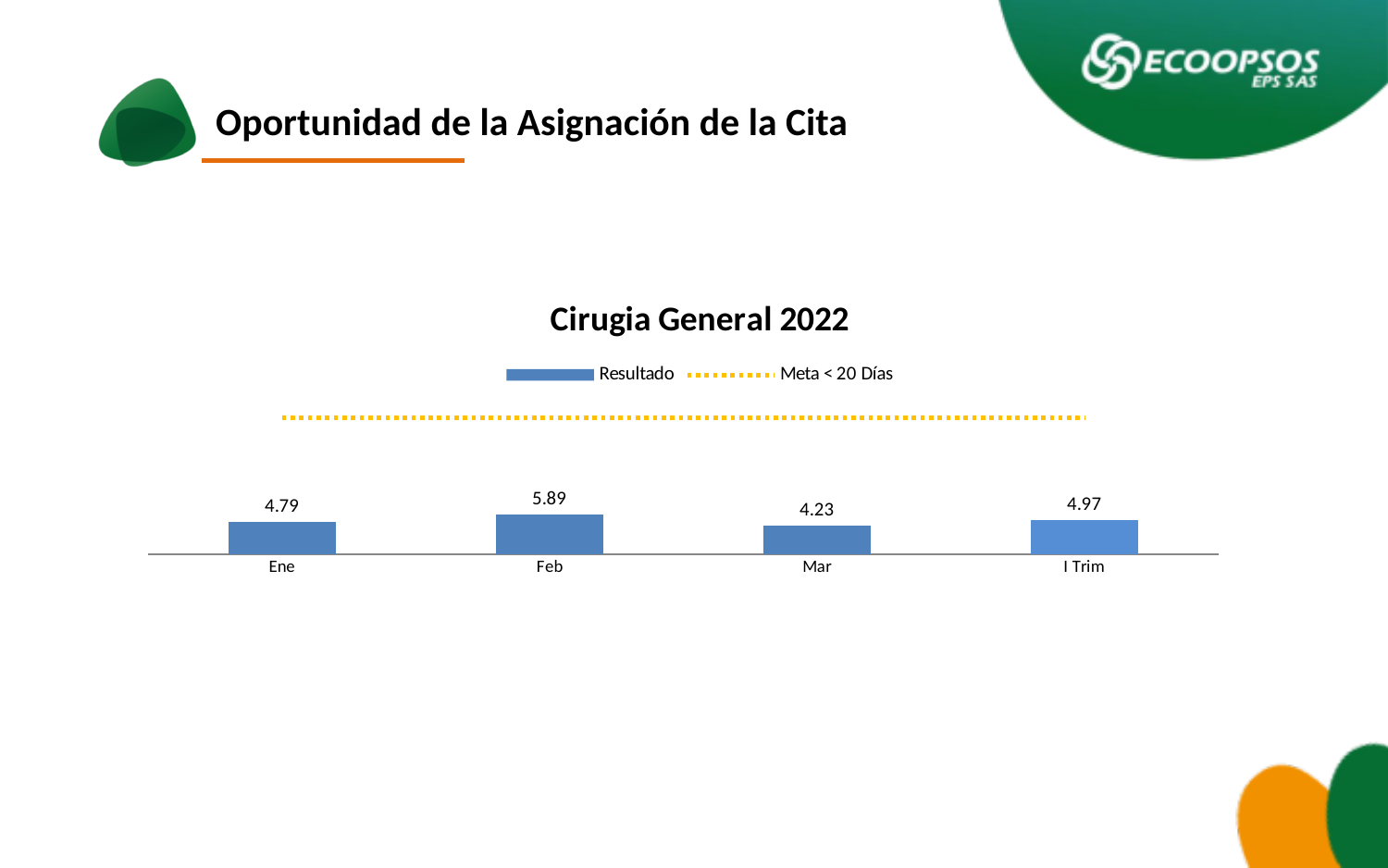
What is the Resultado value for Feb? 5.89 What is the Resultado value for Mar? 4.23 What is the Resultado value for I Trim? 4.97 Which category has the highest Resultado value? Feb What is the difference between the Resultado values for Feb and Mar? 1.66 What is the title of the chart? Cirugia General 2022 Which category has the lowest Resultado value? Mar What is the Resultado value for Ene? 4.79 Which has a larger Resultado value, Ene or I Trim? I Trim How many categories are shown on the x axis? 4 What kind of chart is used to show the Resultado values? Bar chart How many series does the legend list? 2